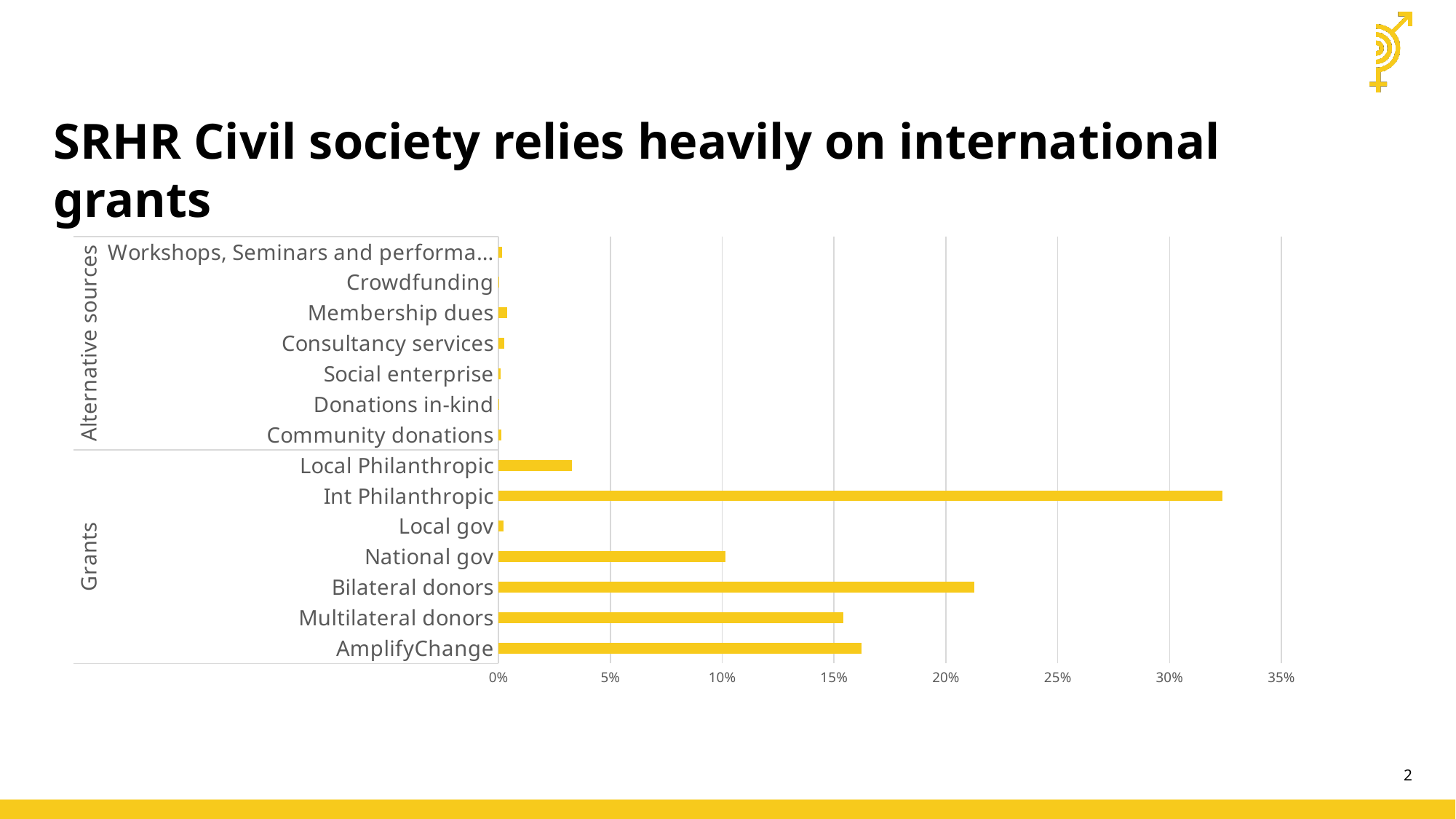
Is the value for Multilateral donors greater or less than 10%? greater Is the value for Bilateral donors greater or less than 20%? greater Which is larger, the value for Bilateral donors or the value for Multilateral donors? Bilateral donors Is the value for National gov greater or less than 15%? less What is the highest tick value shown on the horizontal axis of the chart? 35% Which is larger, the value for National gov or the value for Local Philanthropic? National gov What kind of chart is shown on the slide? Bar chart How many categories are listed on the vertical axis of the chart? 14 What are the two group labels shown along the vertical axis of the chart? Alternative sources and Grants Which category has the highest value in the chart? Int Philanthropic